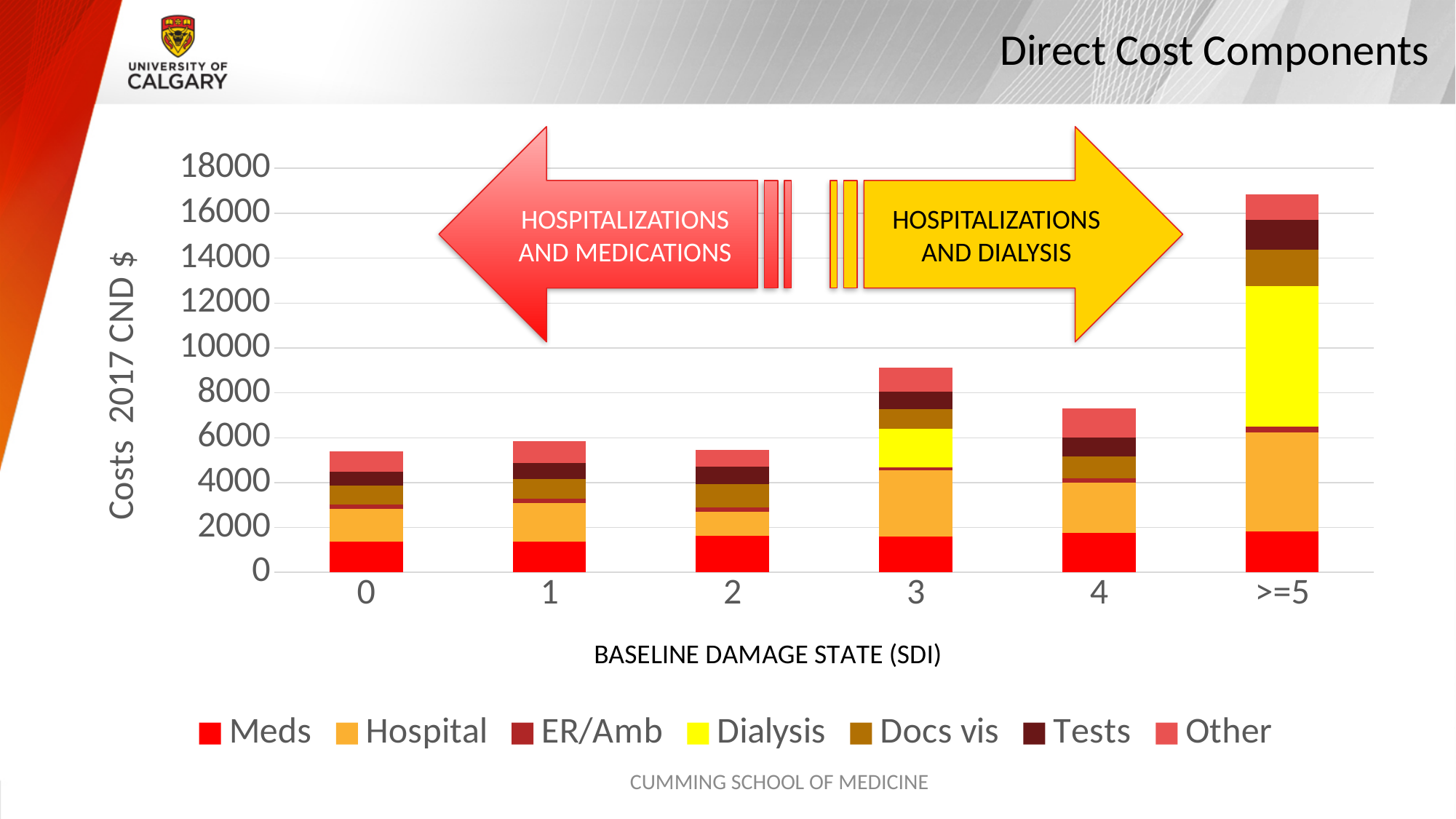
What colour represents the Dialysis series in the legend? Yellow How many baseline damage state categories are shown on the x axis? 6 How many series does the legend list? 7 Is the total cost for baseline damage state 3 greater or less than 10000? less Which baseline damage state has the highest total cost? >=5 Which has a higher total cost, baseline damage state 3 or 4? 3 Is the total cost for baseline damage state >=5 greater or less than 16000? greater Is the total cost for baseline damage state 4 greater or less than 8000? less Which has a higher total cost, baseline damage state >=5 or 3? >=5 What is the title of the slide's chart? Direct Cost Components What kind of chart is shown on the slide? Stacked bar chart